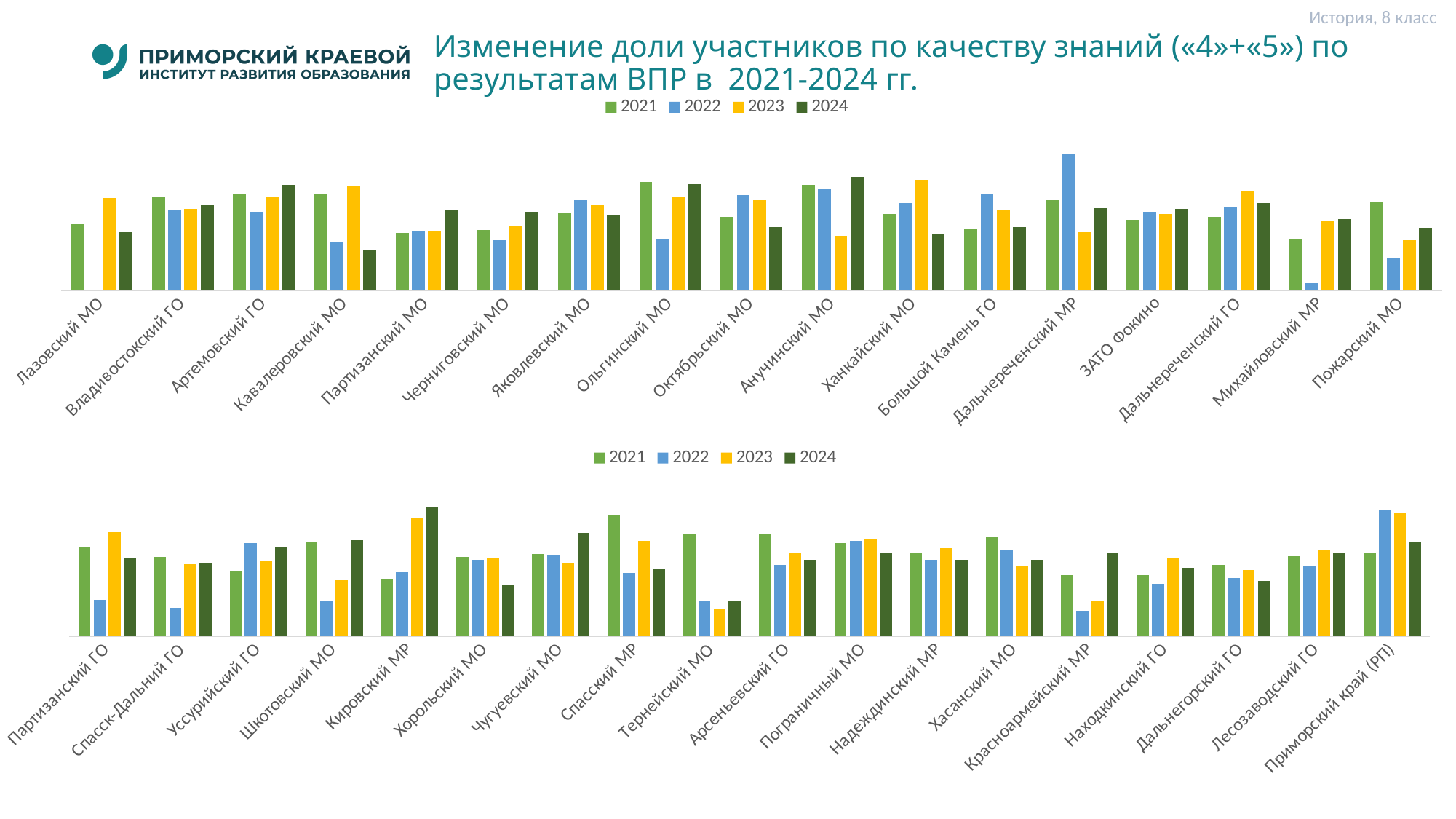
What kind of chart is the top chart on the slide? bar chart In the bottom chart, which year has the highest bar for Кировский МР? 2024 How many categories are shown on the x axis of the bottom chart? 18 In the bottom chart, which year has the highest bar for Тернейский МО? 2021 In the top chart, which year has the highest bar for Дальнереченский МР? 2022 In the bottom chart, which year has the lowest bar for Красноармейский МР? 2022 How many series does the legend of the top chart list? 4 Which years are listed in the legend of the bottom chart? 2021, 2022, 2023, 2024 In the top chart, which year has the lowest bar for Михайловский МР? 2022 In the bottom chart, for Приморский край (РП), is the 2022 bar or the 2021 bar taller? 2022 How many categories are shown on the x axis of the top chart? 17 In the top chart, for Кавалеровский МО, is the 2023 bar or the 2024 bar taller? 2023